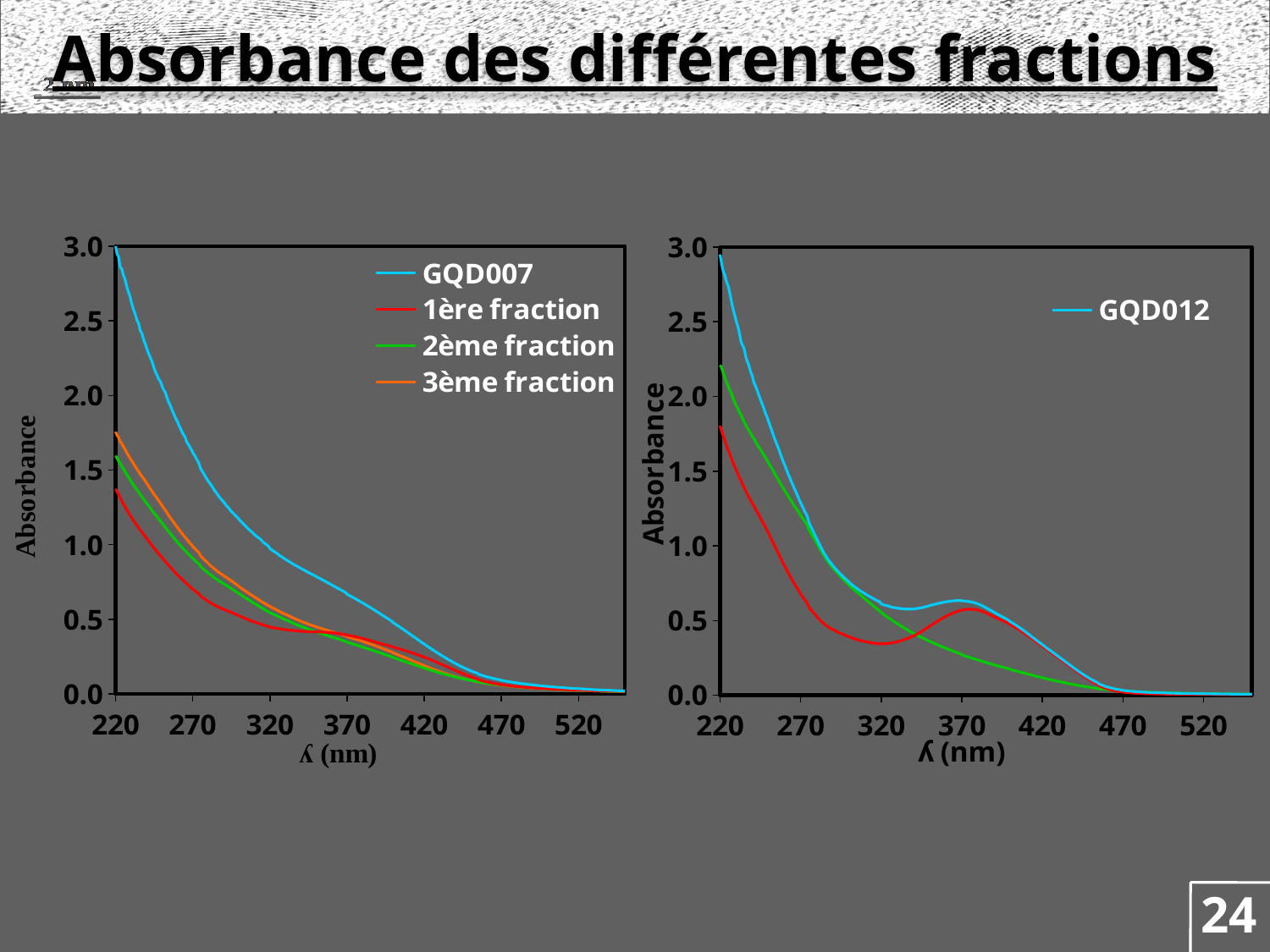
In the left chart, which has the larger absorbance at 270 nm, GQD007 or 2ème fraction? GQD007 What kind of chart is the left chart on the slide? line chart In the left chart, is the absorbance of 1ère fraction at 220 nm greater or less than 1.5? less In the right chart, is the absorbance of GQD012 at 220 nm greater or less than 2.5? greater How many series does the legend of the left chart list? 4 In the left chart, is the absorbance of GQD007 at 220 nm greater or less than 2.5? greater How many series does the legend of the right chart list? 1 What is the label of the y axis on the left chart? Absorbance In the left chart, which series has the highest absorbance at 220 nm? GQD007 In the right chart, does the absorbance of GQD012 generally rise or fall as wavelength increases from 220 nm to 520 nm? fall In the left chart, which series has the lowest absorbance at 220 nm? 1ère fraction